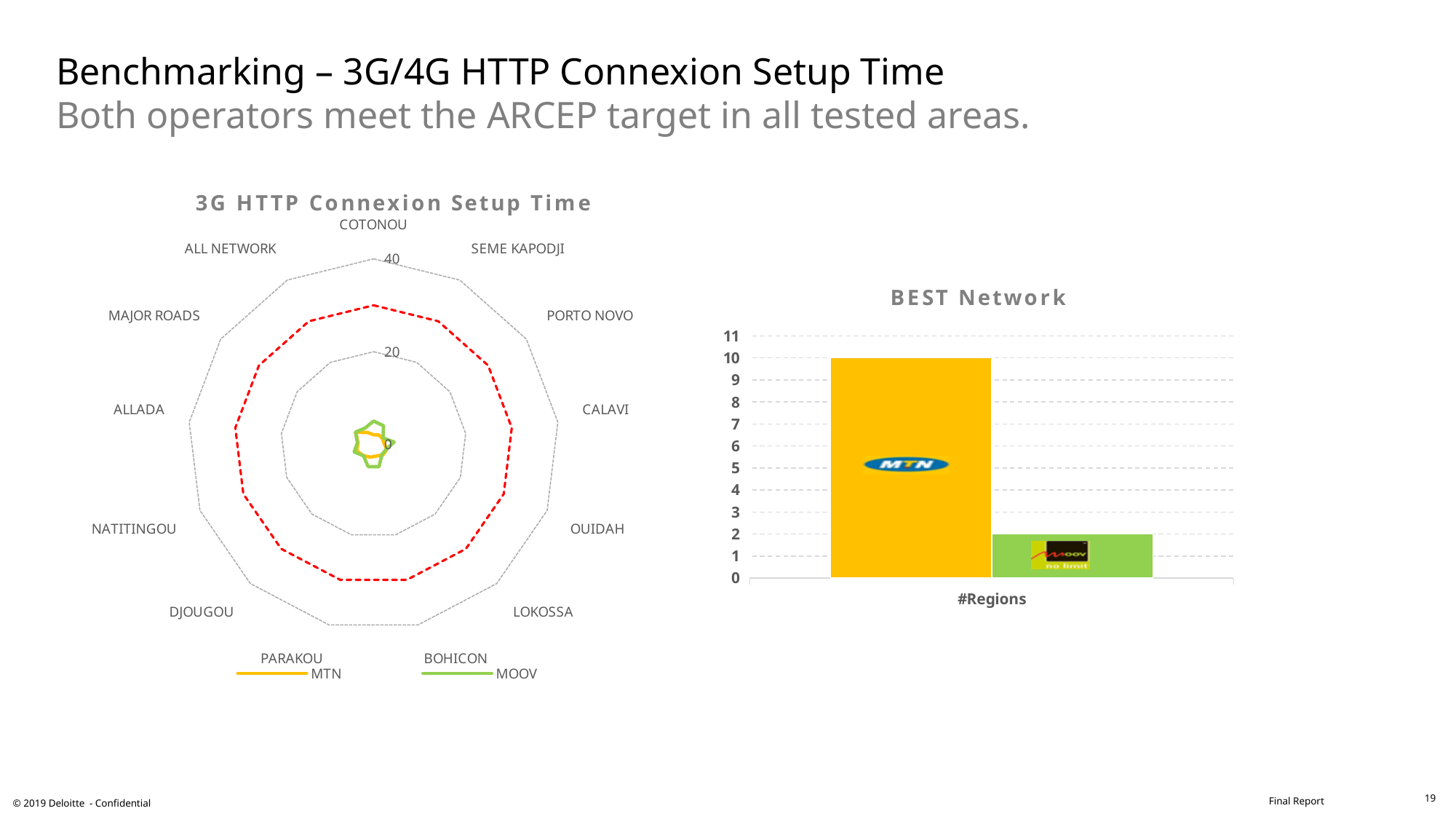
In the BEST Network chart, what is the value of the MOOV bar? 2 How many categories are plotted around the 3G HTTP Connexion Setup Time radar chart? 13 In the BEST Network chart, what is the label on the horizontal axis? #Regions In the BEST Network chart, which operator has the lower bar? MOOV In the 3G HTTP Connexion Setup Time chart, which colour represents MOOV? green In the BEST Network chart, what is the value of the MTN bar? 10 In the BEST Network chart, what is the difference between the MTN and MOOV bars? 8 In the BEST Network chart, which operator has the higher bar? MTN What kind of chart is the BEST Network chart? bar chart What kind of chart is the 3G HTTP Connexion Setup Time chart? radar chart How many series does the legend of the 3G HTTP Connexion Setup Time chart list? 2 In the 3G HTTP Connexion Setup Time chart, is the MTN value for COTONOU greater or less than 20? less